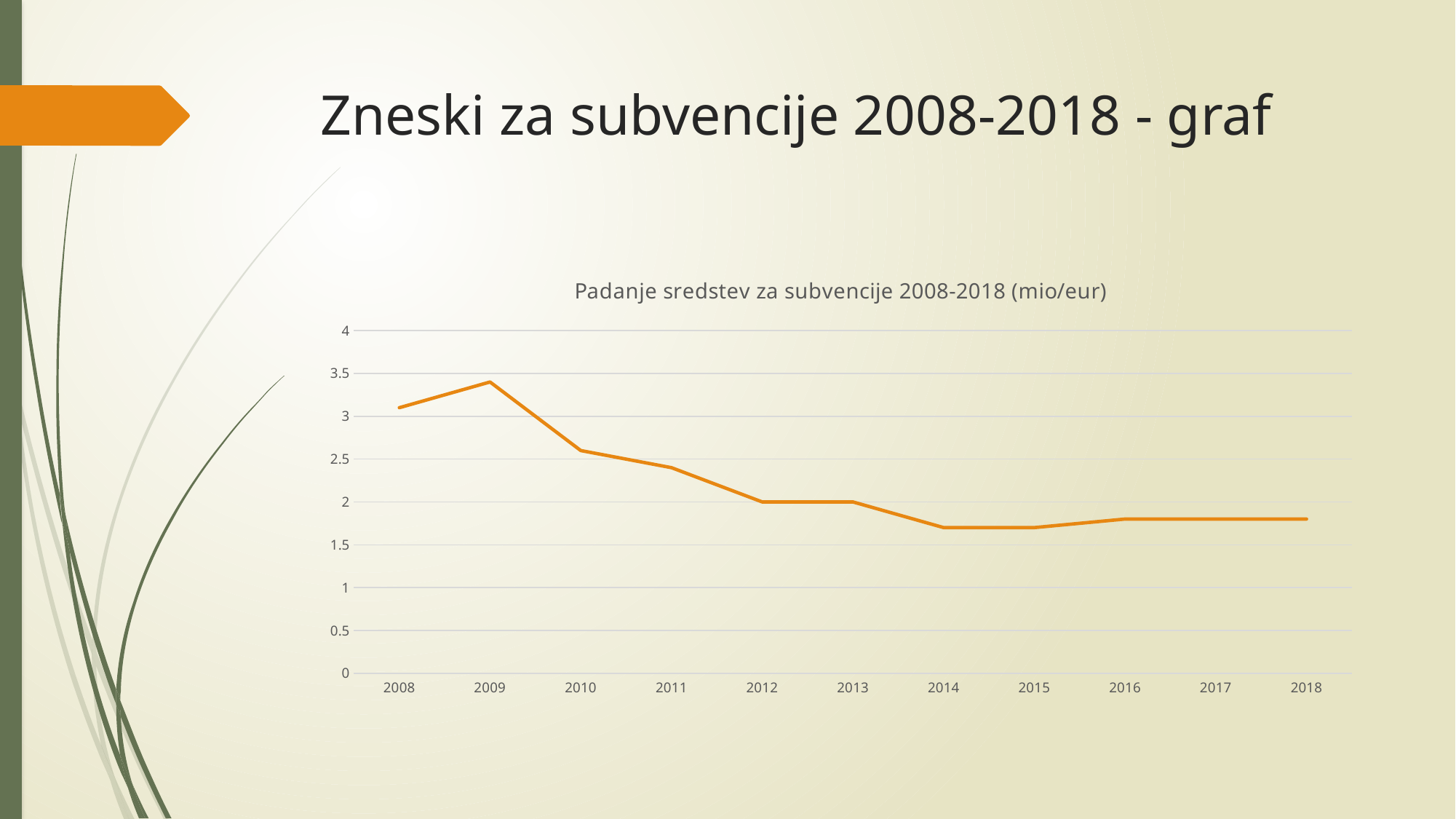
Is the value for 2014 greater or less than 2? less Is the value for 2016 greater or less than 1.5? greater What kind of chart is shown on the slide? line chart Is the value for 2008 greater or less than 3? greater Which is larger, the value for 2009 or the value for 2018? 2009 Do the values generally rise or fall from 2009 to 2014? fall What is the title of the chart? Padanje sredstev za subvencije 2008-2018 (mio/eur) How many years are plotted on the x axis? 11 Which year has the highest value? 2009